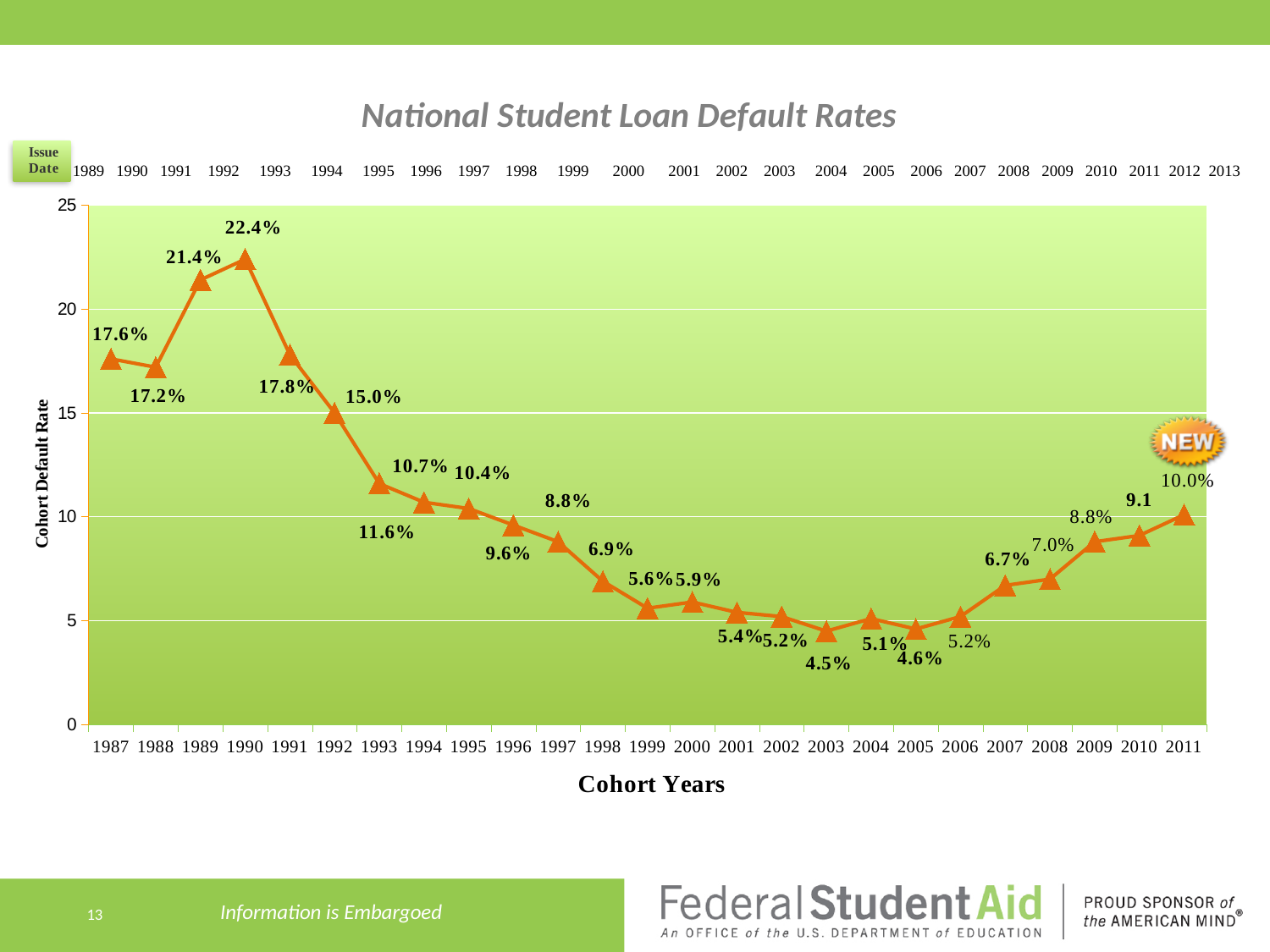
Is the cohort default rate for 1991 greater or less than 15? greater What is the cohort default rate for the 2011 cohort year? 10.0% What kind of chart is shown on the slide? Line chart What is the difference between the cohort default rates for 1990 and 1989? 1.0% How many cohort years are plotted on the chart? 25 Do the cohort default rates rise or fall from 2003 to 2011? Rise What is the title of the chart? National Student Loan Default Rates What is the cohort default rate for the 1990 cohort year? 22.4% Which cohort year has the highest cohort default rate? 1990 What is the cohort default rate for the 2003 cohort year? 4.5% Which cohort year has a higher default rate, 1992 or 1993? 1992 Which cohort year has the lowest cohort default rate? 2003